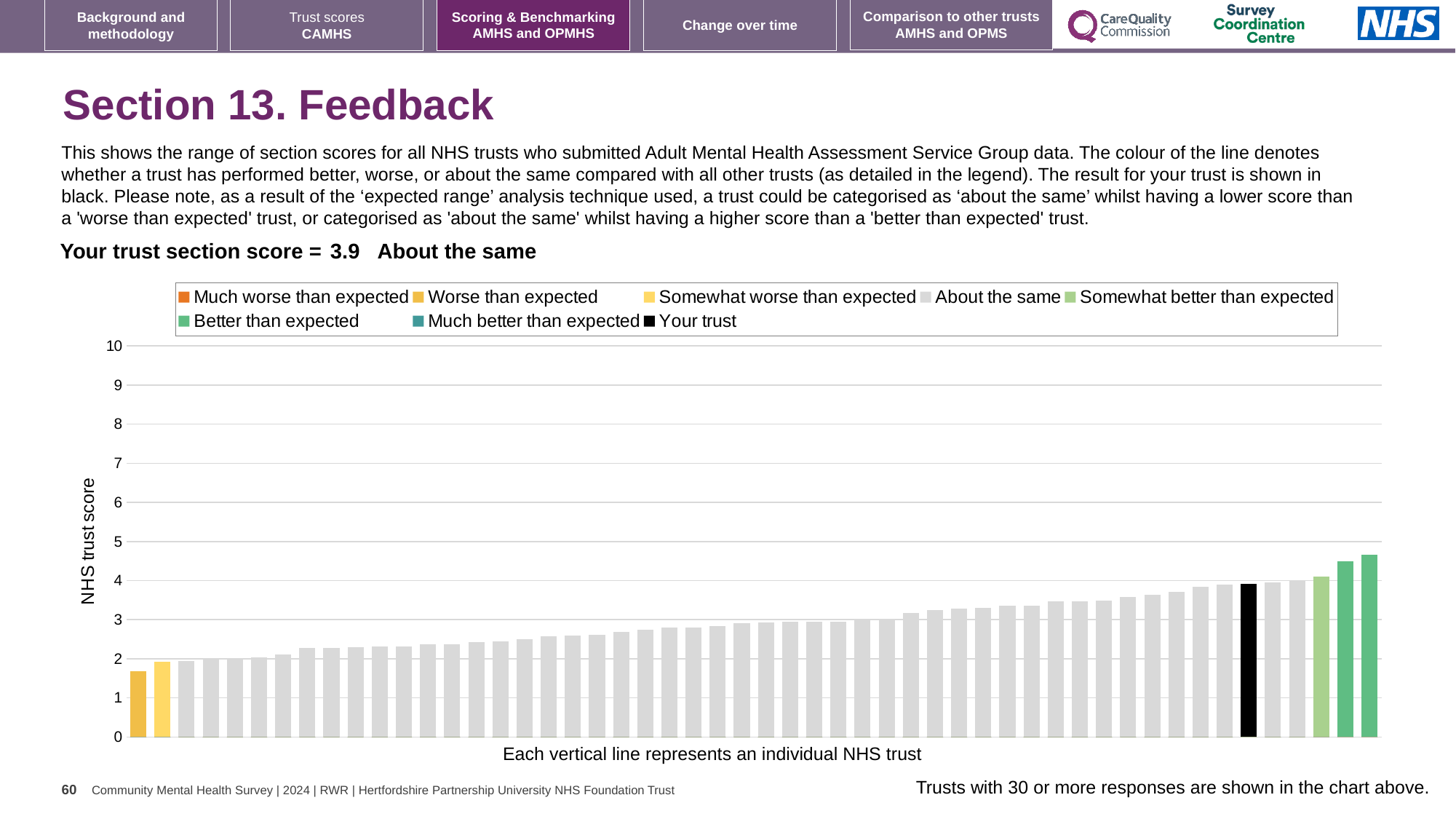
What is the section score for your trust shown on the slide? 3.9 Which is taller, the black bar for your trust or the leftmost bar? the black bar for your trust What does each vertical line in the chart represent, according to the caption below the chart? an individual NHS trust Do the bar values rise or fall from left to right along the x axis? rise What is the label on the vertical axis of the chart? NHS trust score Is the value for your trust (the black bar) greater or less than 3? greater Is the value of the shortest bar greater or less than 2? less Is the value of the tallest bar greater or less than 4? greater What kind of chart is shown on the slide? bar chart How many entries does the chart legend list? 8 Which category is your trust placed in for this section? About the same Which is taller, the black bar for your trust or the rightmost green bar? the rightmost green bar